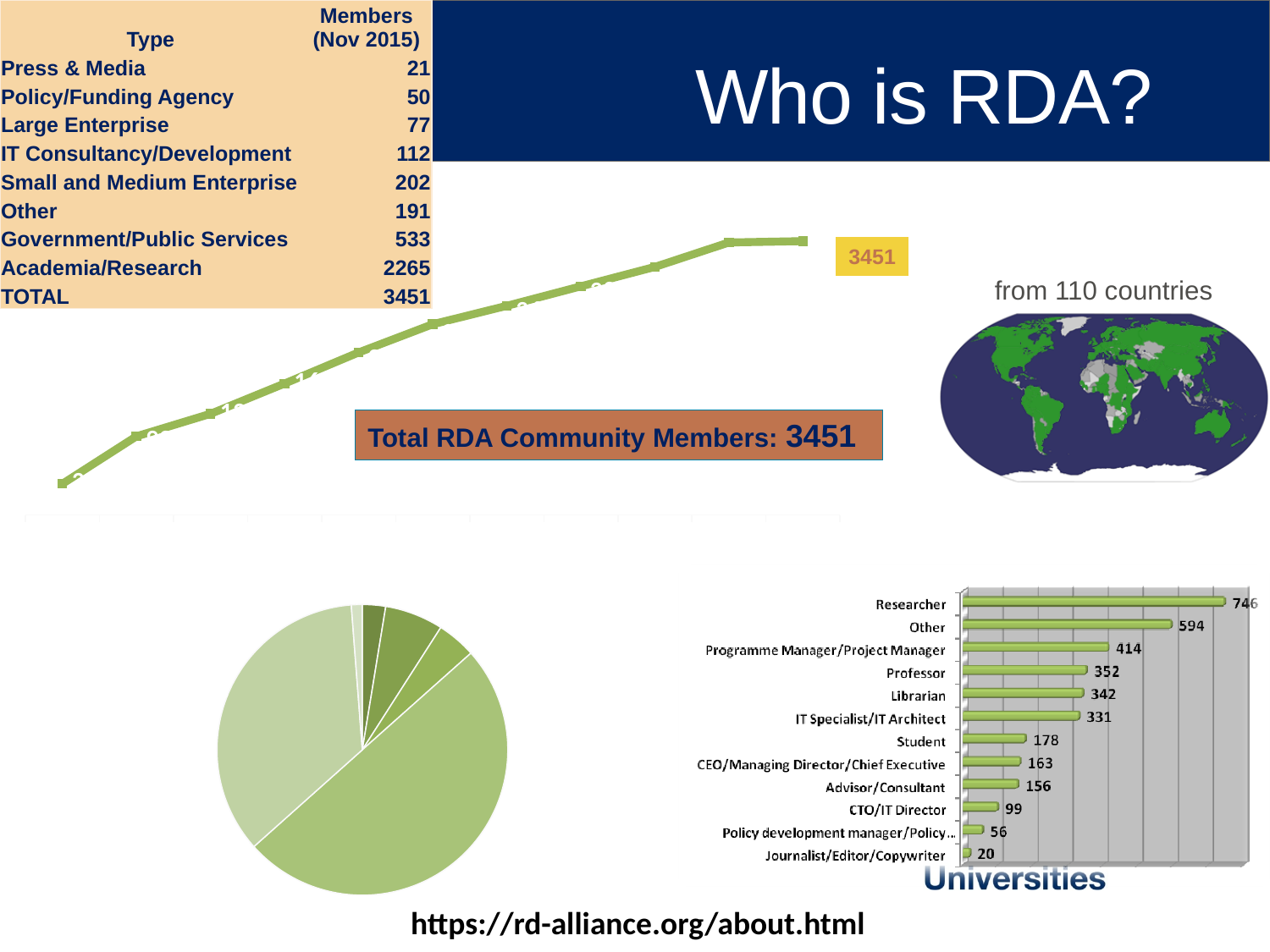
In the bar chart at the bottom right, what is the value for Researcher? 746 In the bar chart at the bottom right, what is the difference between the values for Professor and Librarian? 10 In the bar chart at the bottom right, what is the value for Librarian? 342 In the bar chart at the bottom right, which is larger: the value for Student or the value for Advisor/Consultant? Student In the bar chart at the bottom right, which category has the lowest value? Journalist/Editor/Copywriter In the bar chart at the bottom right, what is the difference between the values for Researcher and Other? 152 What kind of chart is the chart at the bottom right of the slide? Bar chart In the bar chart at the bottom right, which category has the highest value? Researcher In the line chart in the middle of the slide, do the values rise or fall along the x axis? Rise In the bar chart at the bottom right, what is the value for CTO/IT Director? 99 How many categories does the bar chart at the bottom right show? 12 What kind of chart is the chart at the bottom left of the slide? Pie chart